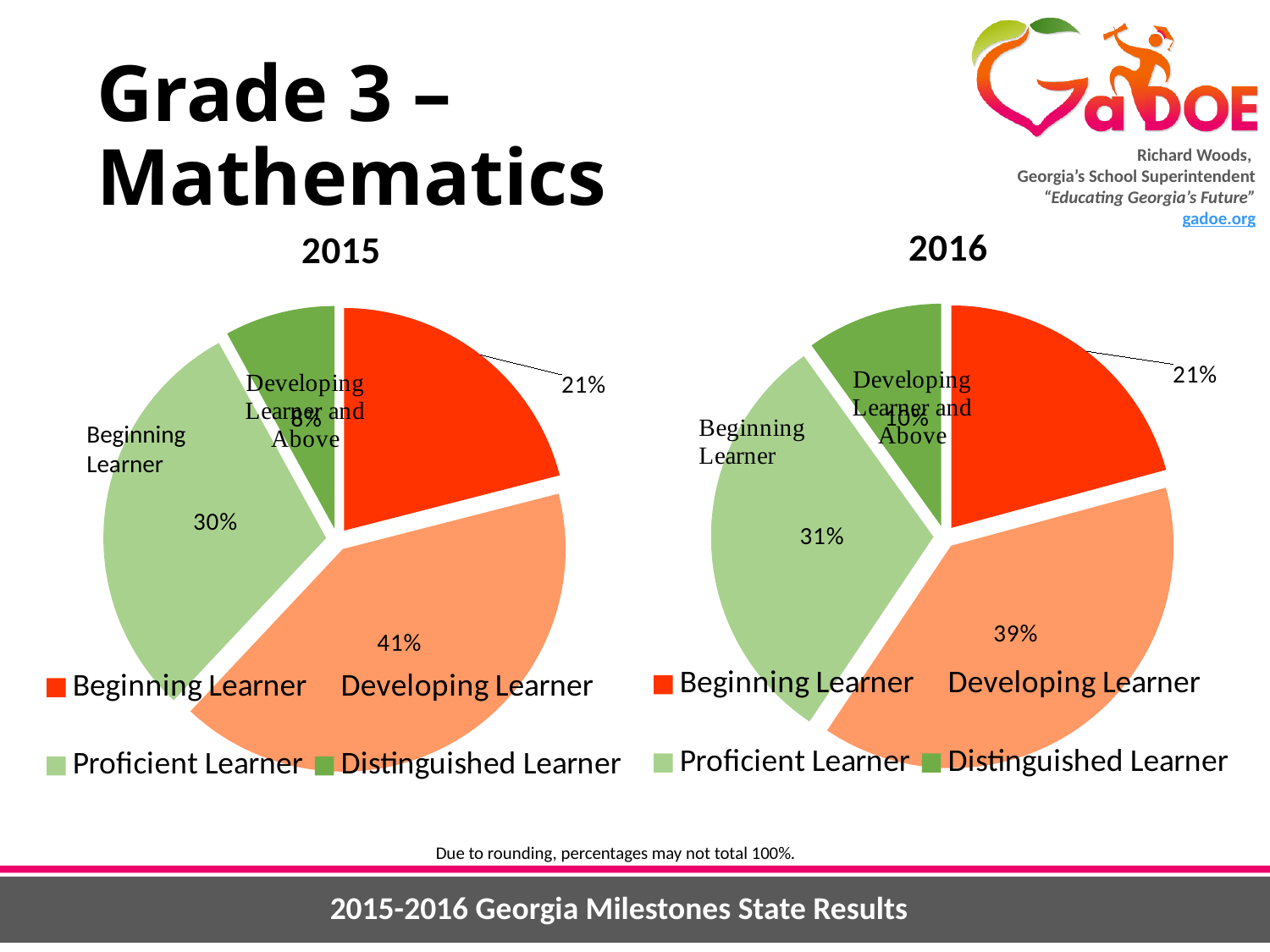
In the 2015 pie chart, which category has the largest slice? Developing Learner In the 2015 pie chart, what is the difference between the Proficient Learner and Distinguished Learner percentages? 22 percentage points In the 2016 pie chart, what percentage is shown for Proficient Learner? 31% What is the difference between the Developing Learner percentage in the 2015 chart and in the 2016 chart? 2 percentage points In the 2015 pie chart, what percentage is shown for Beginning Learner? 21% How many slices does the 2015 pie chart have? 4 In the 2016 pie chart, which category has the smallest slice? Distinguished Learner What type of chart is used for the 2016 results? Pie chart In the 2016 pie chart, which is larger: Proficient Learner or Beginning Learner? Proficient Learner In the 2016 pie chart, what percentage is shown for Distinguished Learner? 10% What colour represents Beginning Learner in the legends of both charts? Red In the 2015 pie chart, what percentage is shown for Developing Learner? 41%